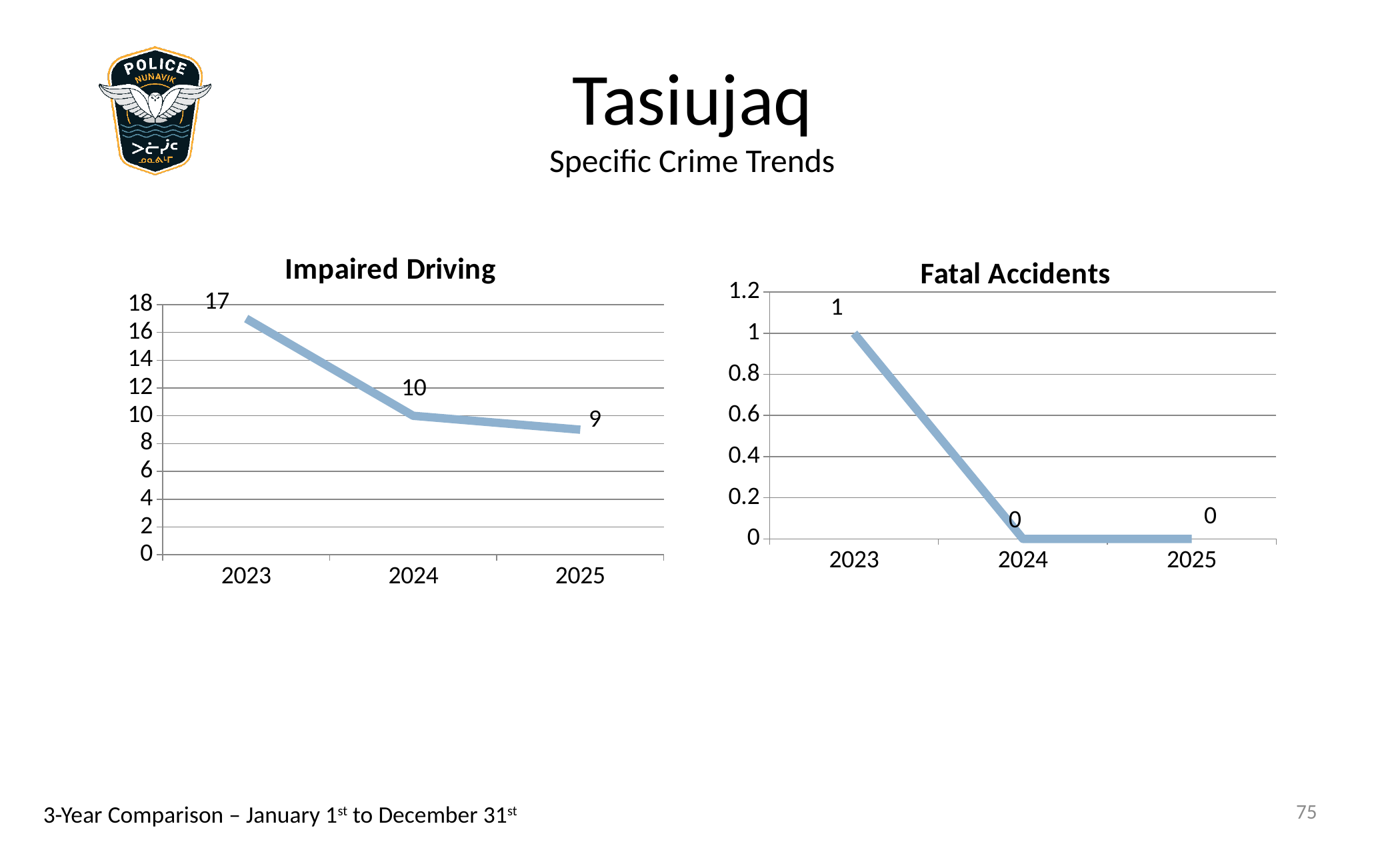
In the Impaired Driving chart, what is the value for 2023? 17 In the Impaired Driving chart, which year has the lowest value? 2025 In the Impaired Driving chart, what is the difference between the 2023 and 2024 values? 7 In the Impaired Driving chart, which year has the highest value? 2023 What kind of chart is the Fatal Accidents chart? line chart In the Impaired Driving chart, how many years are plotted? 3 In the Impaired Driving chart, do the values rise or fall from 2023 to 2025? fall In the Fatal Accidents chart, which year has the highest value? 2023 In the Fatal Accidents chart, what is the value for 2024? 0 In the Impaired Driving chart, what is the value for 2025? 9 In the Fatal Accidents chart, is the value for 2023 larger than the value for 2025? Yes In the Fatal Accidents chart, what is the value for 2023? 1